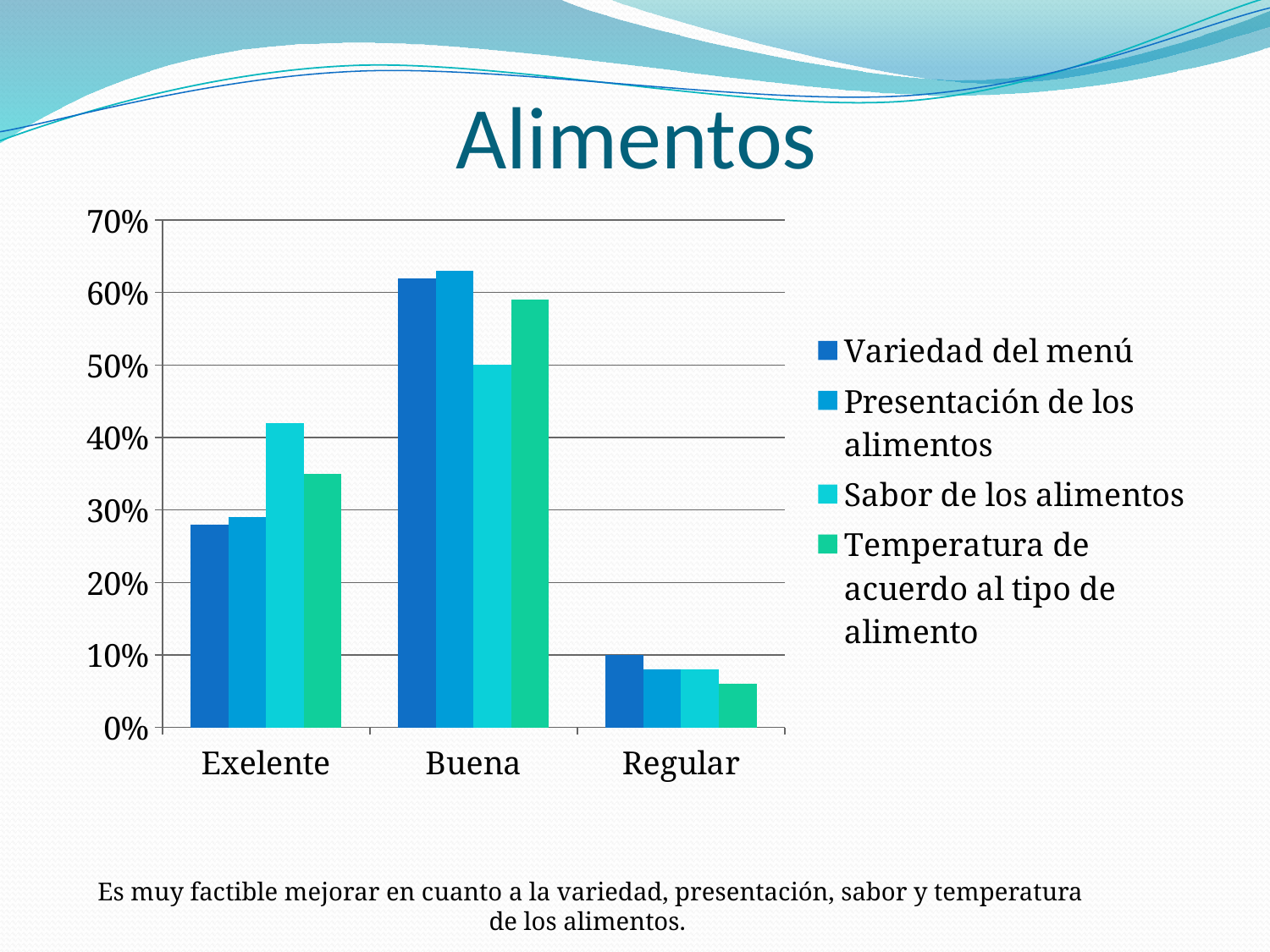
How many categories are shown on the x axis? 3 Which category has the lowest value for Temperatura de acuerdo al tipo de alimento? Regular In the Exelente category, which is larger: Sabor de los alimentos or Variedad del menú? Sabor de los alimentos Is the value for Variedad del menú in the Exelente category greater or less than 30%? less Is the value for Temperatura de acuerdo al tipo de alimento in the Regular category greater or less than 10%? less In the Buena category, which is larger: Temperatura de acuerdo al tipo de alimento or Sabor de los alimentos? Temperatura de acuerdo al tipo de alimento What kind of chart is shown on the slide? bar chart Is the value for Sabor de los alimentos in the Exelente category greater or less than 40%? greater What is the title of the chart? Alimentos How many series does the legend list? 4 Which category has the highest value for Variedad del menú? Buena